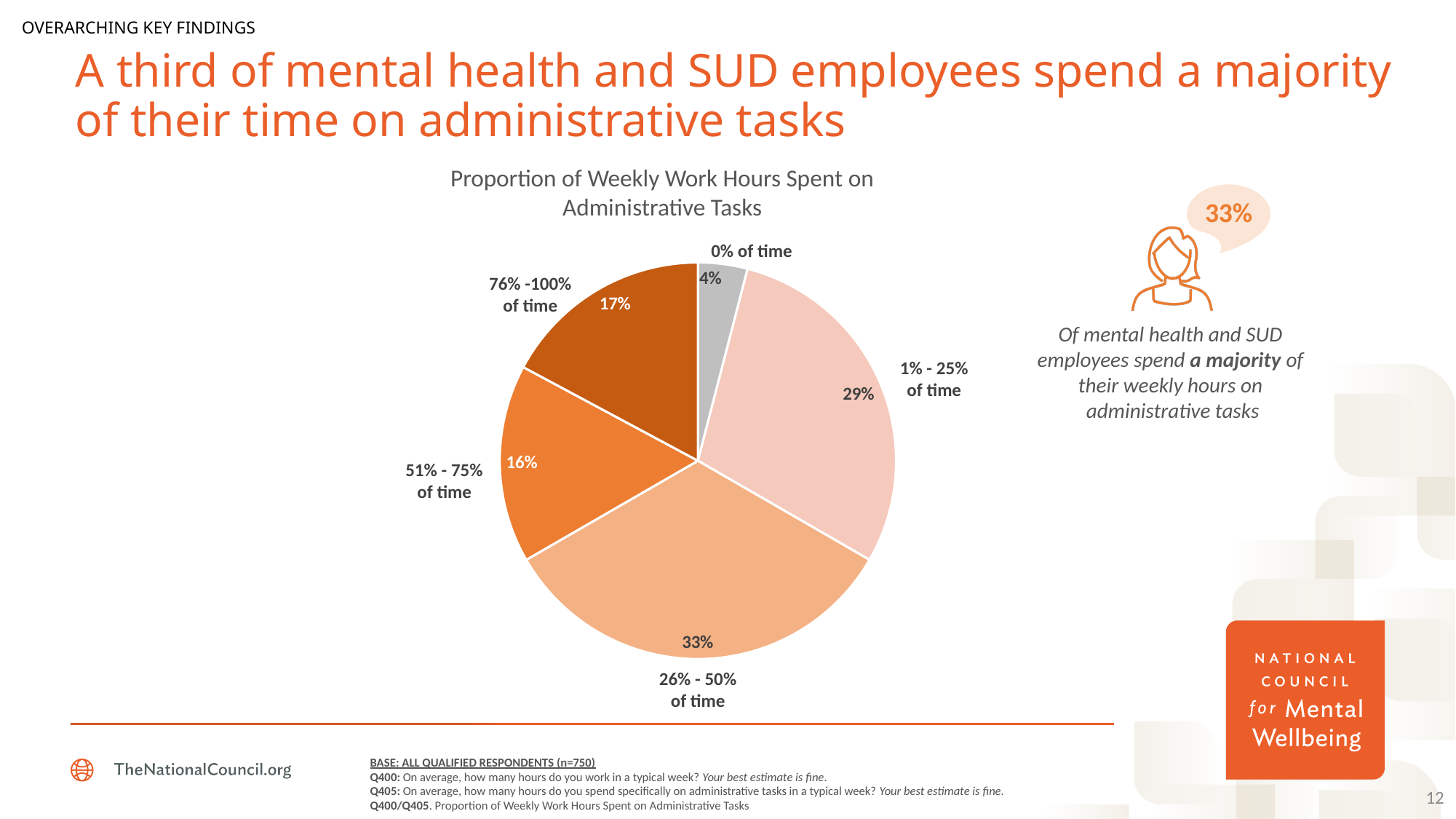
How many slices does the pie chart have? 5 What is the difference between the 1% - 25% of time slice and the 0% of time slice? 25% What percentage of respondents spend 76% -100% of time on administrative tasks? 17% Which category has the largest slice of the pie? 26% - 50% of time What is the title of the chart? Proportion of Weekly Work Hours Spent on Administrative Tasks What type of chart is shown on the slide? pie chart What percentage of respondents spend 0% of time on administrative tasks? 4% What is the combined share of the 51% - 75% of time and 76% -100% of time slices? 33% Which is larger, the 1% - 25% of time slice or the 76% -100% of time slice? 1% - 25% of time What percentage of respondents spend 51% - 75% of time on administrative tasks? 16% What percentage of respondents spend 26% - 50% of time on administrative tasks? 33% Which category has the smallest slice of the pie? 0% of time